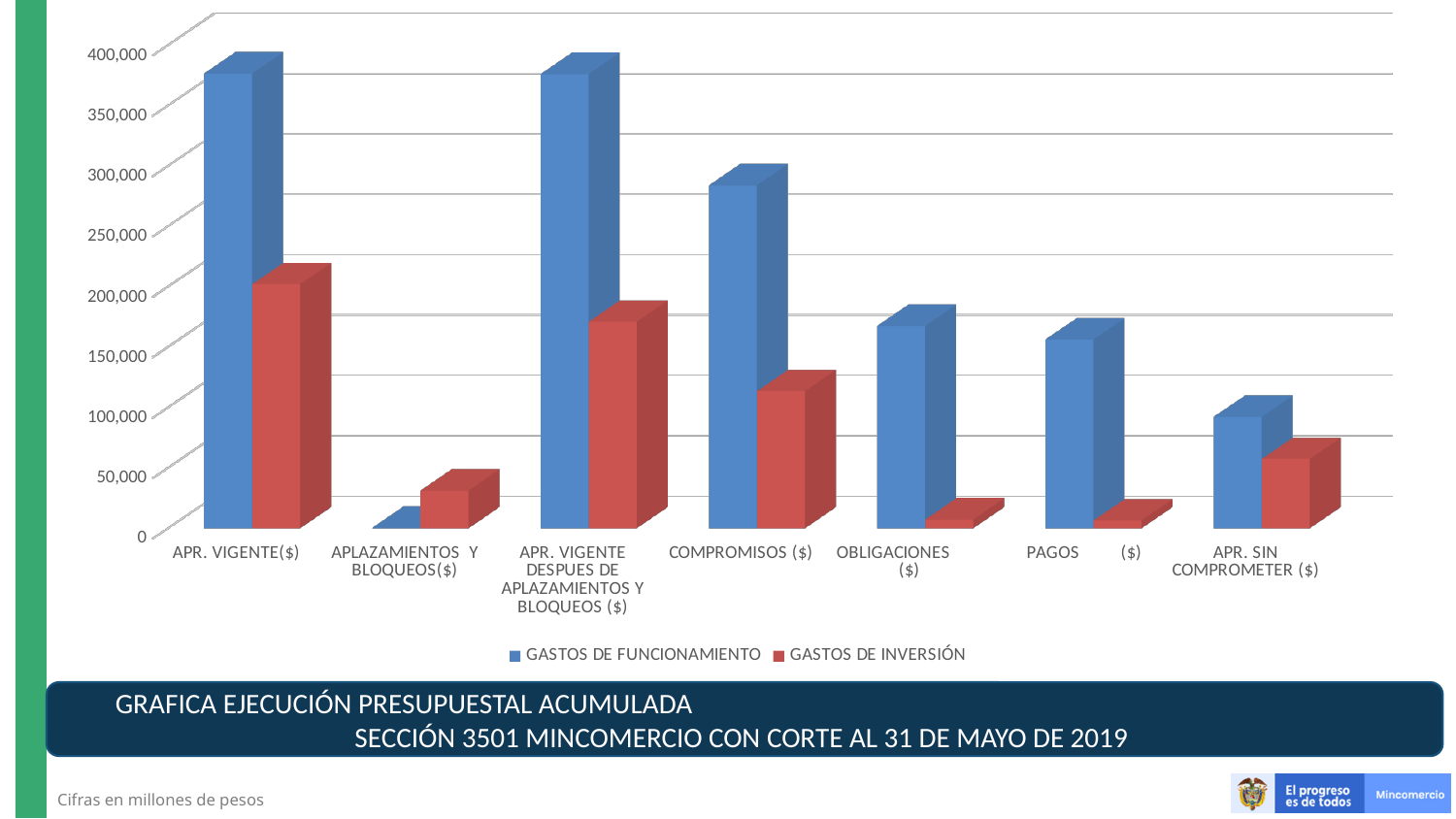
Is the GASTOS DE INVERSIÓN value for OBLIGACIONES ($) greater or less than 50,000? less Which category has the highest value for GASTOS DE INVERSIÓN? APR. VIGENTE($) Is the GASTOS DE INVERSIÓN value for APR. VIGENTE($) greater or less than 150,000? greater How many categories are shown along the x axis? 7 Is the GASTOS DE FUNCIONAMIENTO value for COMPROMISOS ($) greater or less than 250,000? greater For APLAZAMIENTOS Y BLOQUEOS($), which series has the larger value, GASTOS DE FUNCIONAMIENTO or GASTOS DE INVERSIÓN? GASTOS DE INVERSIÓN Which colour represents GASTOS DE INVERSIÓN in the legend? red What kind of chart is shown on the slide? bar chart Which category has the lowest value for GASTOS DE FUNCIONAMIENTO? APLAZAMIENTOS Y BLOQUEOS($) For COMPROMISOS ($), which series has the larger value, GASTOS DE FUNCIONAMIENTO or GASTOS DE INVERSIÓN? GASTOS DE FUNCIONAMIENTO How many series does the legend list? 2